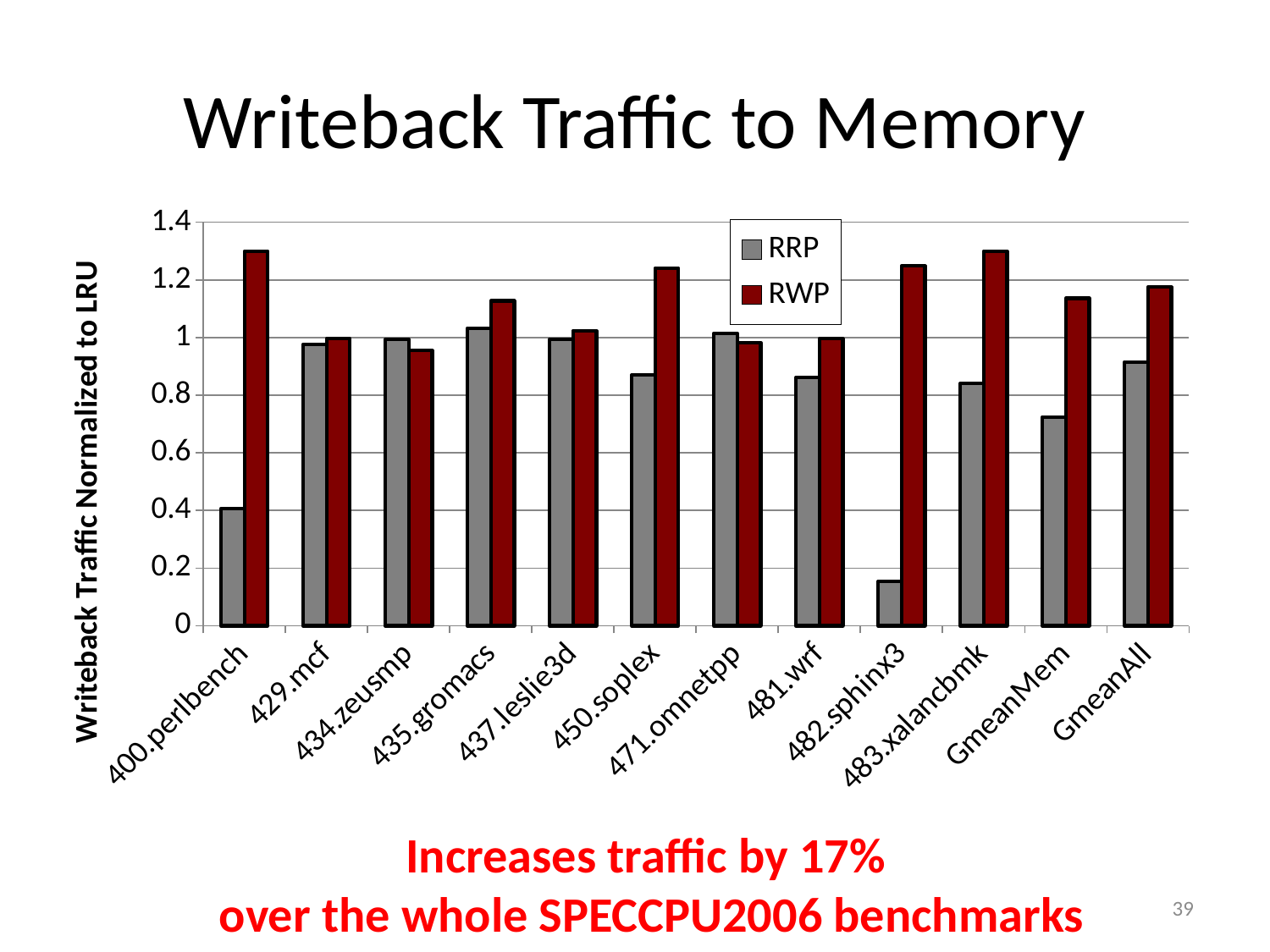
For 450.soplex, which series has the larger value, RRP or RWP? RWP How many benchmark categories are shown on the x axis? 12 What is the label on the y axis? Writeback Traffic Normalized to LRU Is the RRP value for GmeanMem greater or less than 0.8? less How many series does the legend list? 2 Which category has the lowest RRP value? 482.sphinx3 Is the RWP value for 483.xalancbmk greater or less than 1.2? greater What kind of chart is shown on the slide? bar chart Is the RWP value for 400.perlbench greater or less than 1.2? greater What is the title of the chart? Writeback Traffic to Memory